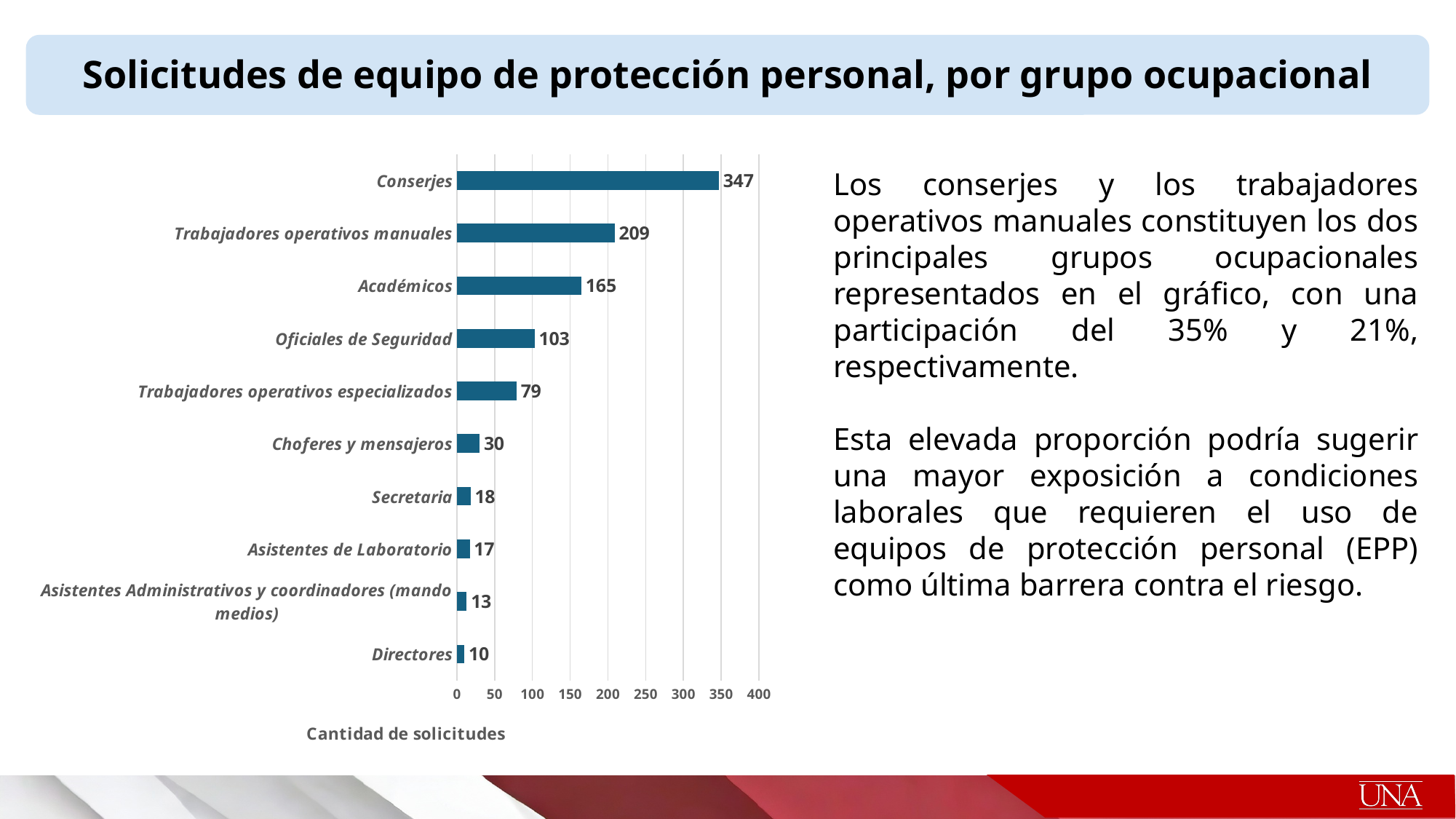
Is the value for Académicos greater or less than 150? greater How many solicitudes are shown for Conserjes? 347 What kind of chart is shown on the slide? Bar chart What is the label of the horizontal axis of the chart? Cantidad de solicitudes What is the value for Asistentes de Laboratorio? 17 Which occupational group has the highest number of solicitudes? Conserjes What is the difference between the values for Oficiales de Seguridad and Trabajadores operativos especializados? 24 Which occupational group has the lowest number of solicitudes? Directores How many occupational groups are shown in the chart? 10 What is the difference between the values for Conserjes and Trabajadores operativos manuales? 138 Which is larger, the value for Choferes y mensajeros or the value for Secretaria? Choferes y mensajeros What is the value for Académicos? 165